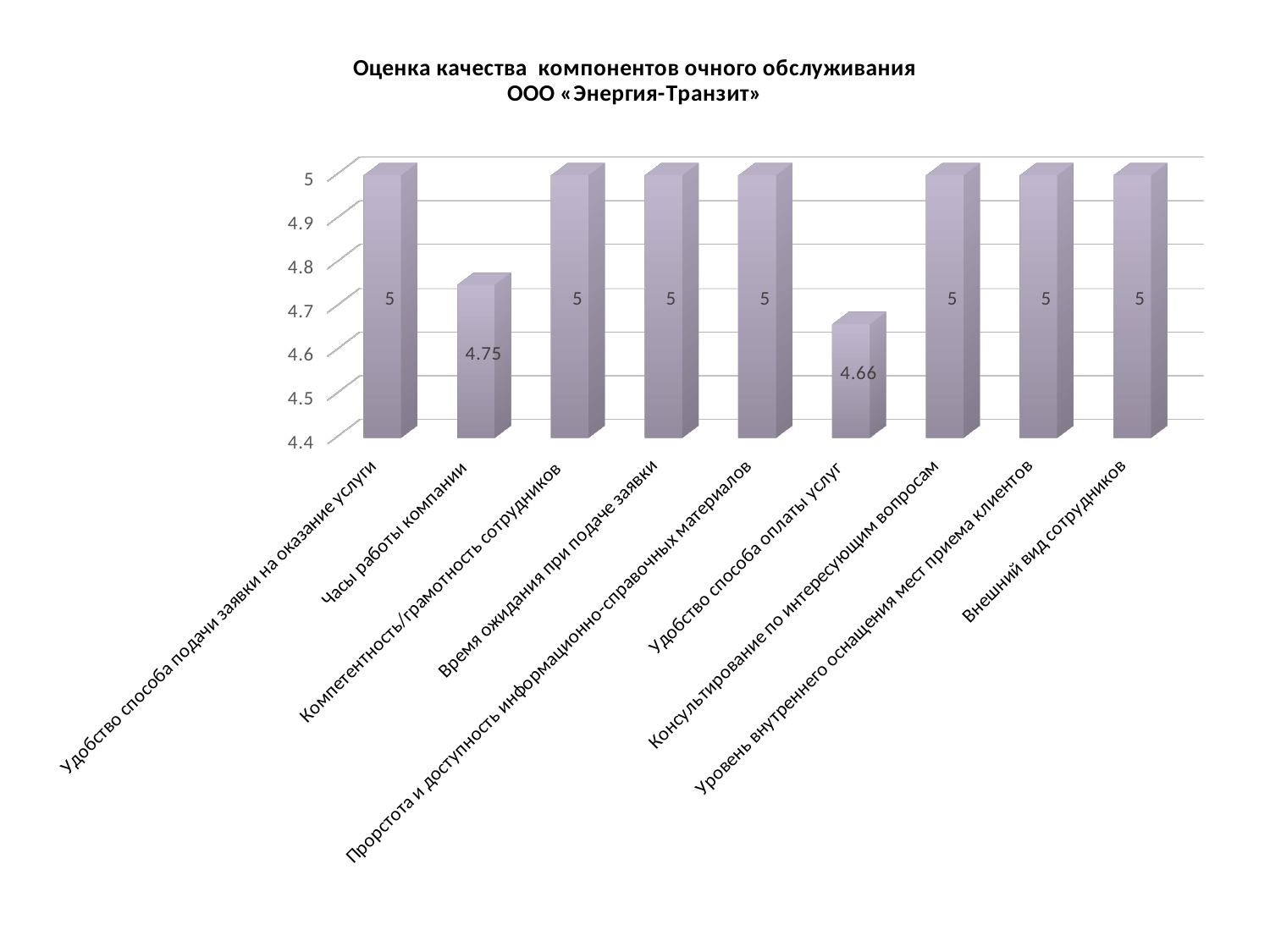
What is the difference between the values for «Часы работы компании» and «Удобство способа оплаты услуг»? 0.09 Is the value for «Часы работы компании» greater or less than 4.8? less What is the difference between the values for «Внешний вид сотрудников» and «Удобство способа оплаты услуг»? 0.34 What kind of chart is shown on the slide? bar chart What is the value for «Часы работы компании»? 4.75 What is the value for «Компетентность/грамотность сотрудников»? 5 Which is larger, the value for «Часы работы компании» or the value for «Удобство способа оплаты услуг»? Часы работы компании What is the value for «Внешний вид сотрудников»? 5 Which category has the lowest value? Удобство способа оплаты услуг How many categories are shown on the chart? 9 What is the value for «Удобство способа оплаты услуг»? 4.66 What is the title of the chart? Оценка качества компонентов очного обслуживания ООО «Энергия-Транзит»